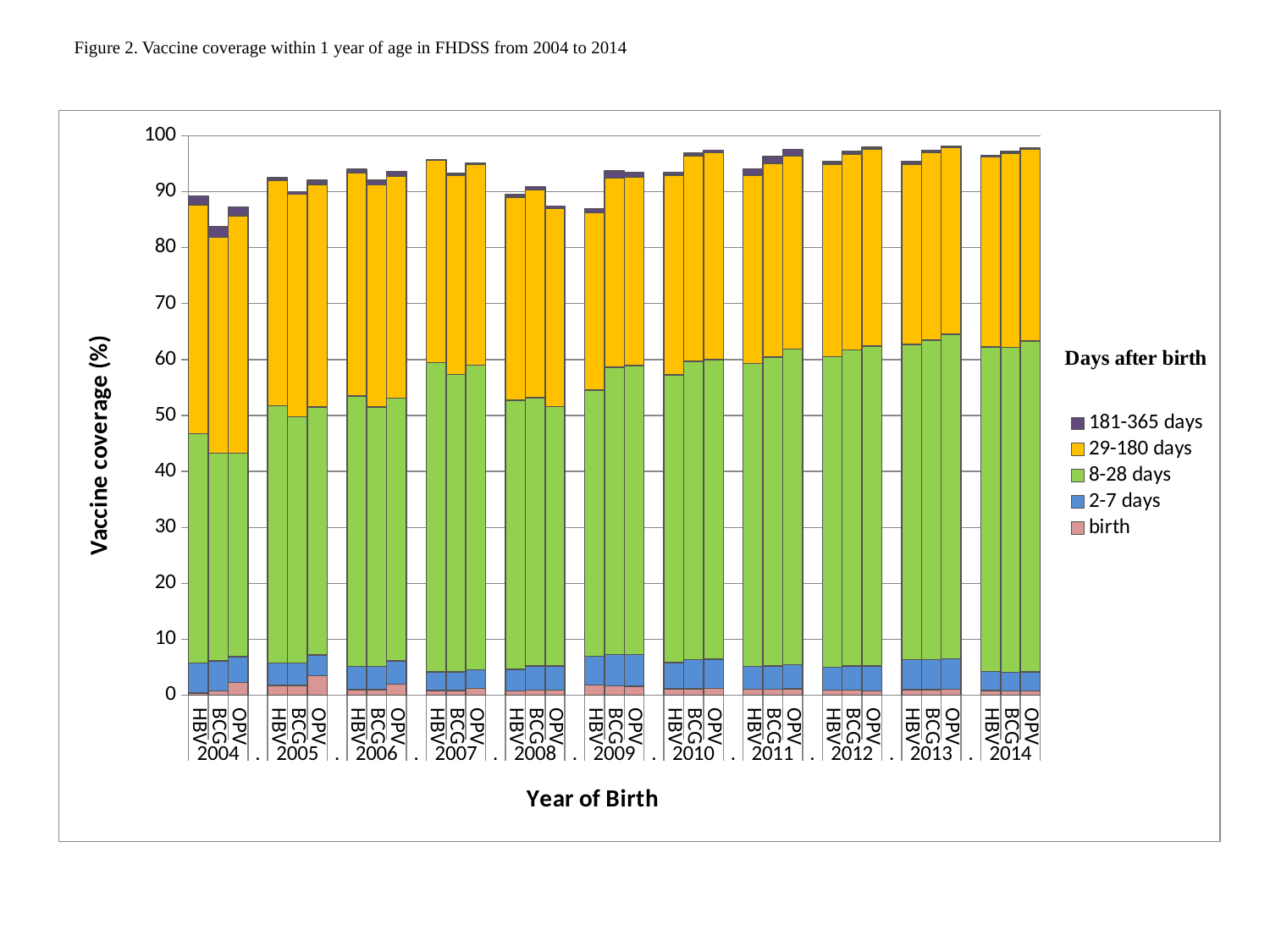
Does total vaccine coverage generally rise or fall from 2004 to 2014? rise What kind of chart is shown on the slide? stacked bar chart What is the title of the legend? Days after birth Is the total vaccine coverage for OPV in 2008 greater or less than 90? less Is the total vaccine coverage for BCG in 2004 greater or less than 90? less Which vaccine-year bar has the lowest total coverage? BCG 2004 Is the total vaccine coverage for OPV in 2014 greater or less than 90? greater How many birth years are shown along the x axis? 11 How many vaccines are shown for each birth year? 3 How many series does the legend list? 5 What is the label of the y axis? Vaccine coverage (%) Which has the higher total coverage, HBV in 2004 or BCG in 2004? HBV in 2004